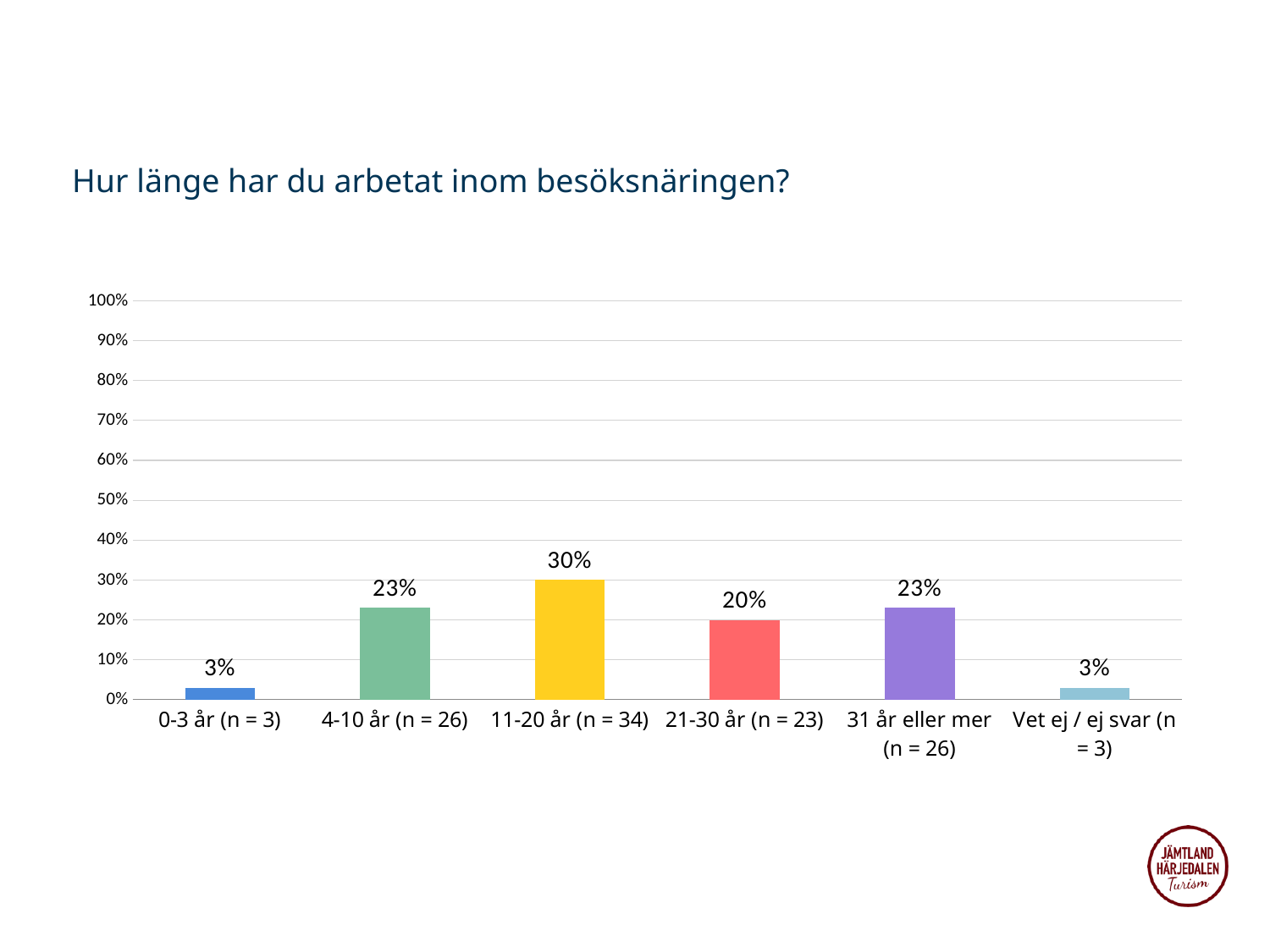
What is the title of the chart? Hur länge har du arbetat inom besöksnäringen? What is the difference in percentage points between "31 år eller mer (n = 26)" and "Vet ej / ej svar (n = 3)"? 20 percentage points Is the value for "11-20 år (n = 34)" greater or less than 40%? less Which category has the highest percentage? 11-20 år (n = 34) What percentage is shown for the category "0-3 år (n = 3)"? 3% Which is larger, the value for "4-10 år (n = 26)" or the value for "21-30 år (n = 23)"? 4-10 år (n = 26) What percentage is shown for the category "11-20 år (n = 34)"? 30% How many categories are shown on the x axis? 6 What percentage is shown for the category "21-30 år (n = 23)"? 20% What kind of chart is shown on the slide? Bar chart What is the difference in percentage points between "11-20 år (n = 34)" and "21-30 år (n = 23)"? 10 percentage points What colour is the bar for "11-20 år (n = 34)"? Yellow